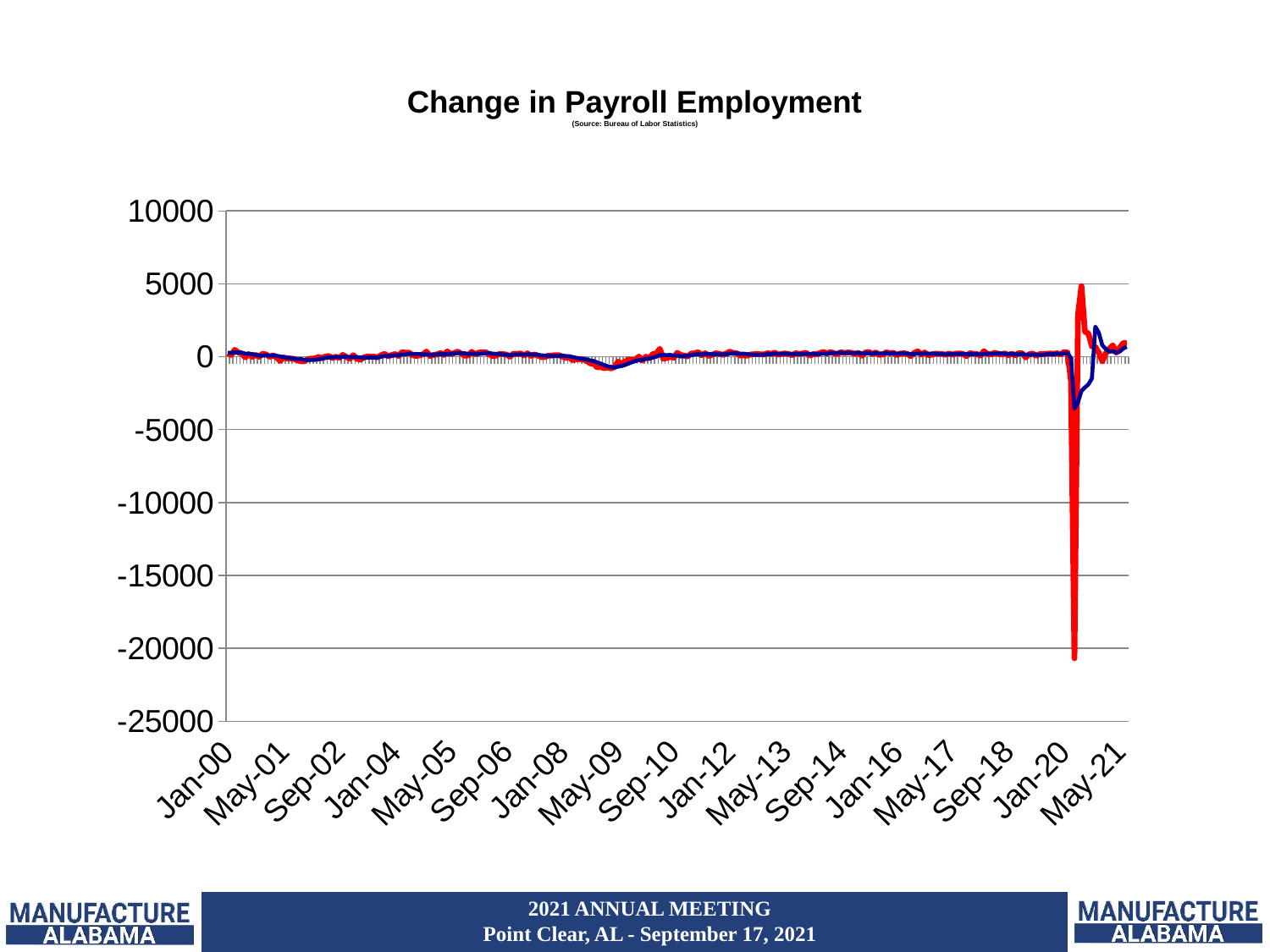
Is the highest value of the red line, reached after Jan-20, greater or less than 10000? less What kind of chart is shown on the slide? line chart Is the lowest value of the blue line, reached shortly after Jan-20, greater or less than -5000? greater How many lines are plotted on the chart? 2 Is the highest value of the blue line, reached after Jan-20, greater or less than 5000? less Which line reaches the lowest value on the chart, the red line or the blue line? red line What is the title of the chart? Change in Payroll Employment Between Jan-00 and Sep-18, do the plotted values stay close to 0 or swing widely? close to 0